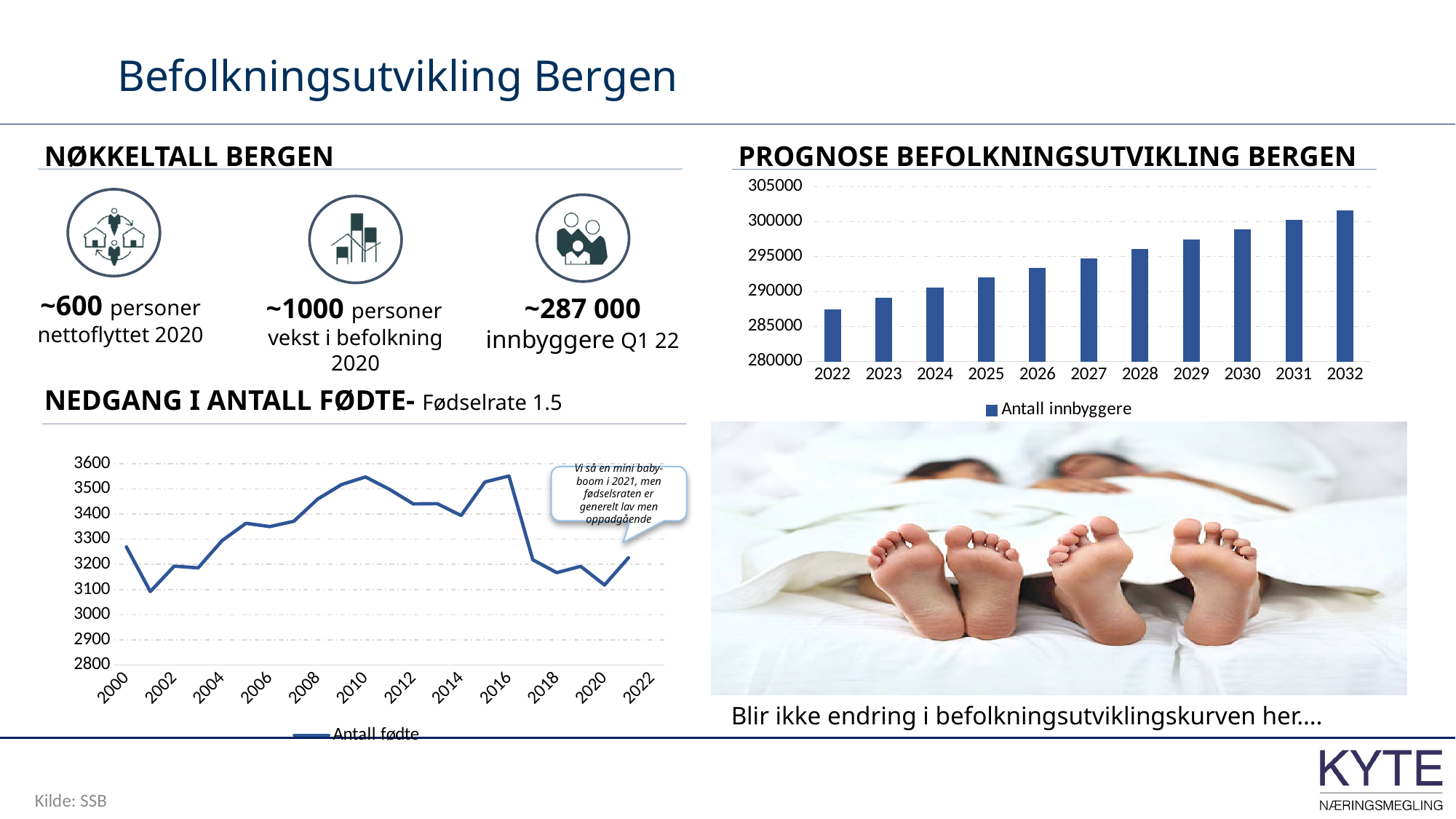
In the 'PROGNOSE BEFOLKNINGSUTVIKLING BERGEN' chart, is the value for 2022 greater or less than 290000? less In the 'PROGNOSE BEFOLKNINGSUTVIKLING BERGEN' chart, do the values rise or fall from 2022 to 2032? Rise In the 'PROGNOSE BEFOLKNINGSUTVIKLING BERGEN' chart, is the value for 2032 greater or less than 300000? greater In the 'PROGNOSE BEFOLKNINGSUTVIKLING BERGEN' chart, which year has the lowest value? 2022 In the 'NEDGANG I ANTALL FØDTE' chart, what series name does the legend show? Antall fødte In the 'PROGNOSE BEFOLKNINGSUTVIKLING BERGEN' chart, how many years are shown on the x axis? 11 In the 'PROGNOSE BEFOLKNINGSUTVIKLING BERGEN' chart, what series name does the legend show? Antall innbyggere In the 'PROGNOSE BEFOLKNINGSUTVIKLING BERGEN' chart, is the value for 2030 greater or less than 295000? greater What kind of chart is the 'NEDGANG I ANTALL FØDTE' chart? Line chart In the 'PROGNOSE BEFOLKNINGSUTVIKLING BERGEN' chart, which year has the highest value? 2032 What kind of chart is the 'PROGNOSE BEFOLKNINGSUTVIKLING BERGEN' chart? Bar chart